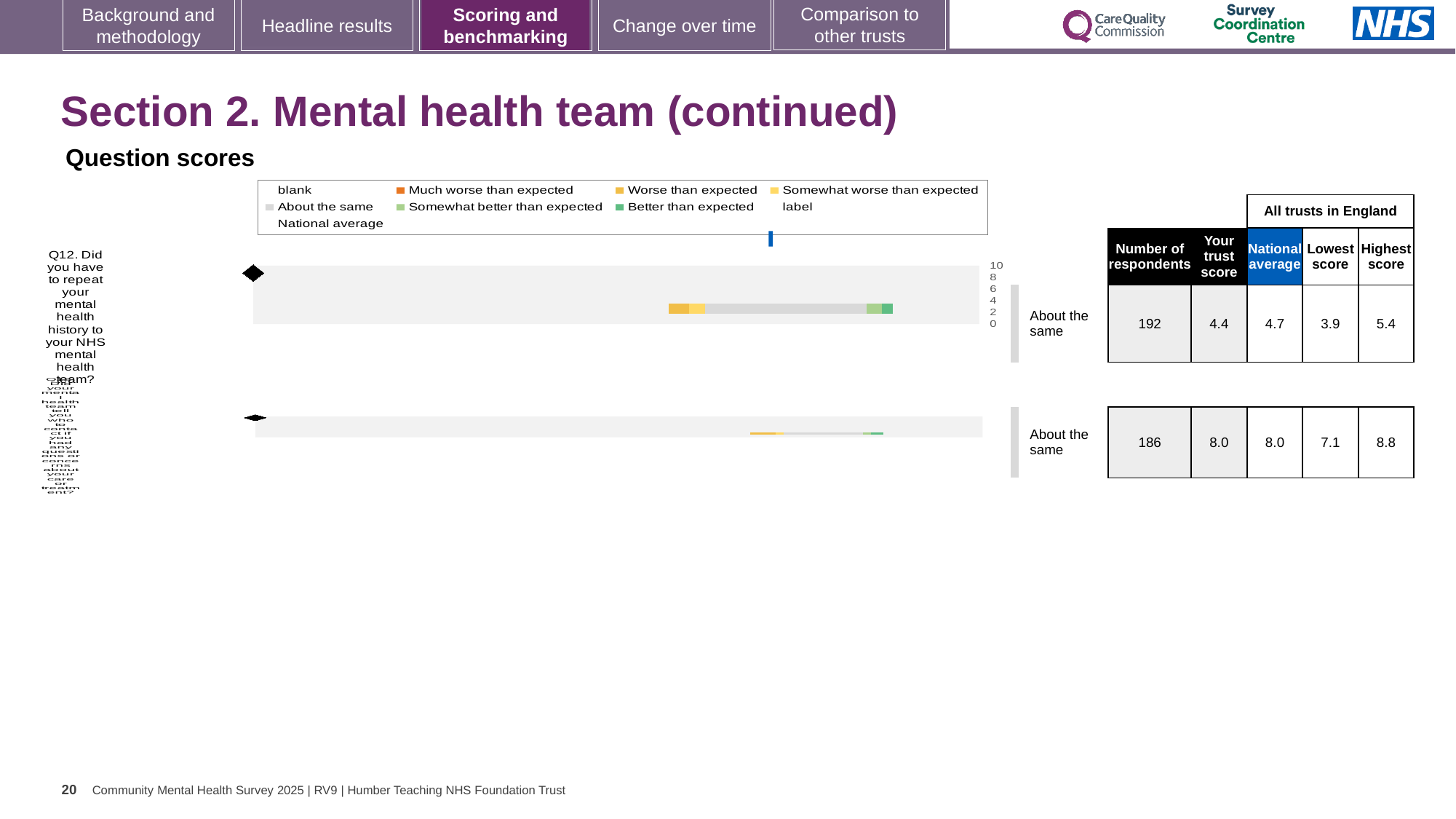
What is the trust score for Q12 (Did you have to repeat your mental health history to your NHS mental health team?)? 4.4 How is the trust's result for Q12 categorised relative to expectation? About the same How many respondents answered Q12? 192 For the second (lower) question row on the chart, what is the difference between the highest and lowest scores among all trusts in England? 1.7 What is the lowest score among all trusts in England for Q12? 3.9 Which is larger for Q12: the trust score or the national average? National average How many question rows are plotted on the chart? 2 What is the highest score among all trusts in England for Q12? 5.4 For the second (lower) question row on the chart, what is the trust score? 8.0 What colour does the legend use for 'Much worse than expected'? Orange What is the national average score for Q12? 4.7 What is the difference between the national average and the trust score for Q12? 0.3